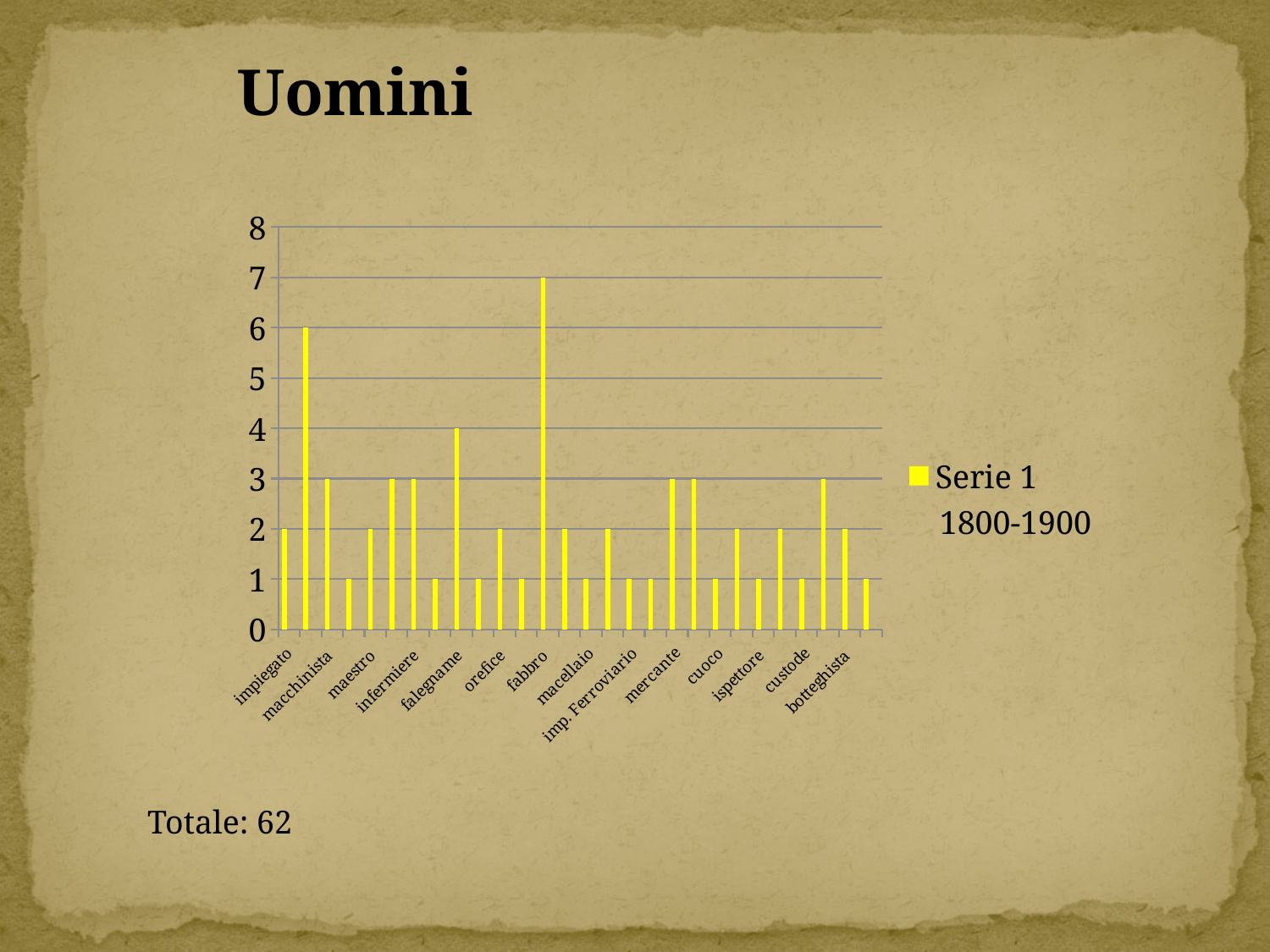
What colour are the bars in the chart? yellow What is the difference between the values for fabbro and falegname? 3 What is the value for macchinista? 3 Is the value for fabbro greater or less than 5? greater Which category has the highest value? fabbro What is the value for falegname? 4 Which is larger, the value for mercante or the value for cuoco? mercante How many series does the legend list? 1 What is the title of the chart? Uomini What kind of chart is shown on the slide? bar chart What is the value for fabbro? 7 What is the value for impiegato? 2